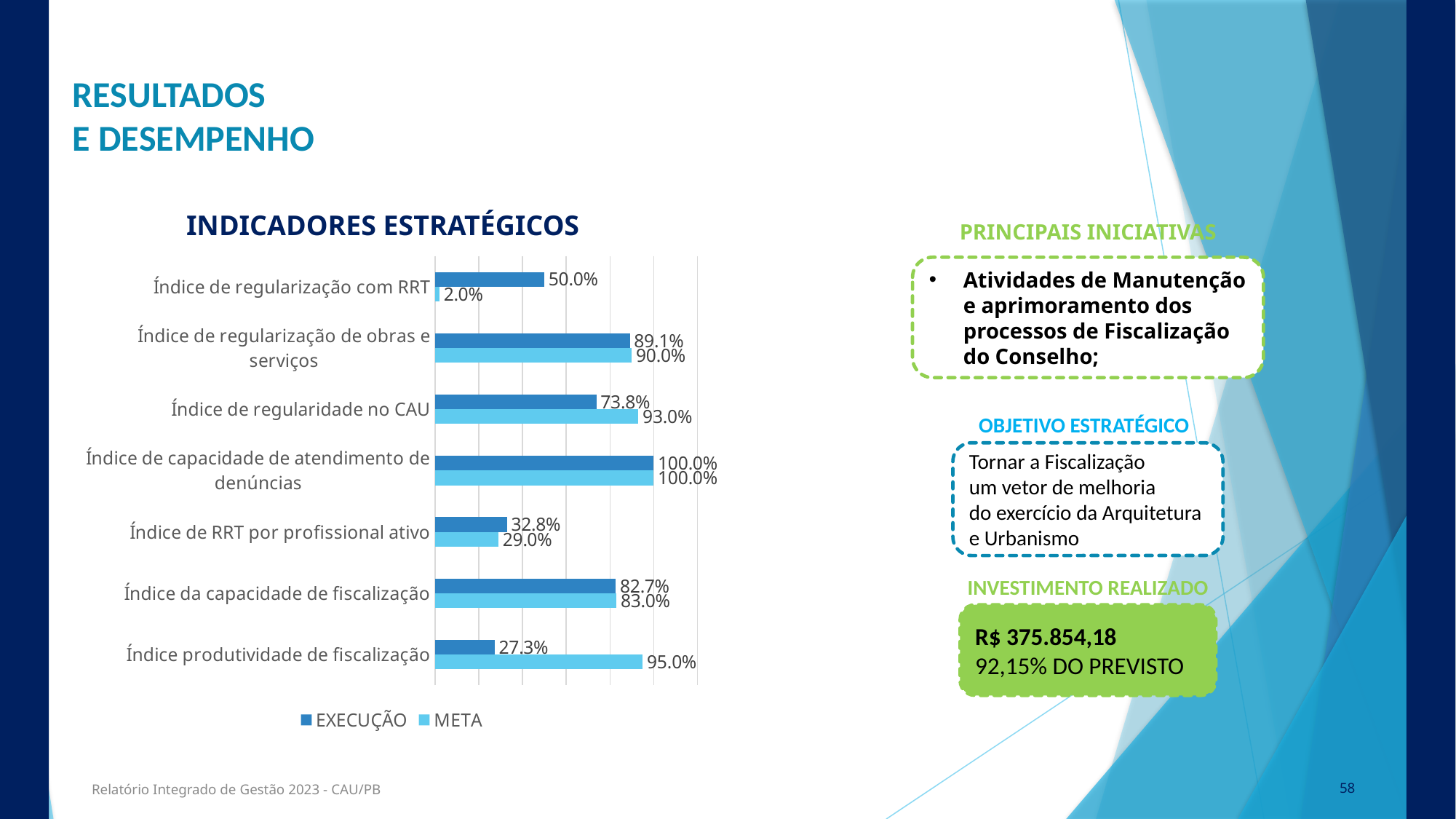
How many series does the legend list? 2 What is the META value for Índice produtividade de fiscalização? 95.0% Which category has the lowest META value? Índice de regularização com RRT For Índice de RRT por profissional ativo, which is larger: EXECUÇÃO or META? EXECUÇÃO What type of chart is shown on the slide? Bar chart How many categories are shown in the chart? 7 What is the EXECUÇÃO value for Índice de regularização com RRT? 50.0% Which category has the lowest EXECUÇÃO value? Índice produtividade de fiscalização What is the EXECUÇÃO value for Índice de RRT por profissional ativo? 32.8% What is the META value for Índice de regularidade no CAU? 93.0% What is the title of the chart? INDICADORES ESTRATÉGICOS What is the difference between the META and EXECUÇÃO values for Índice produtividade de fiscalização? 67.7%